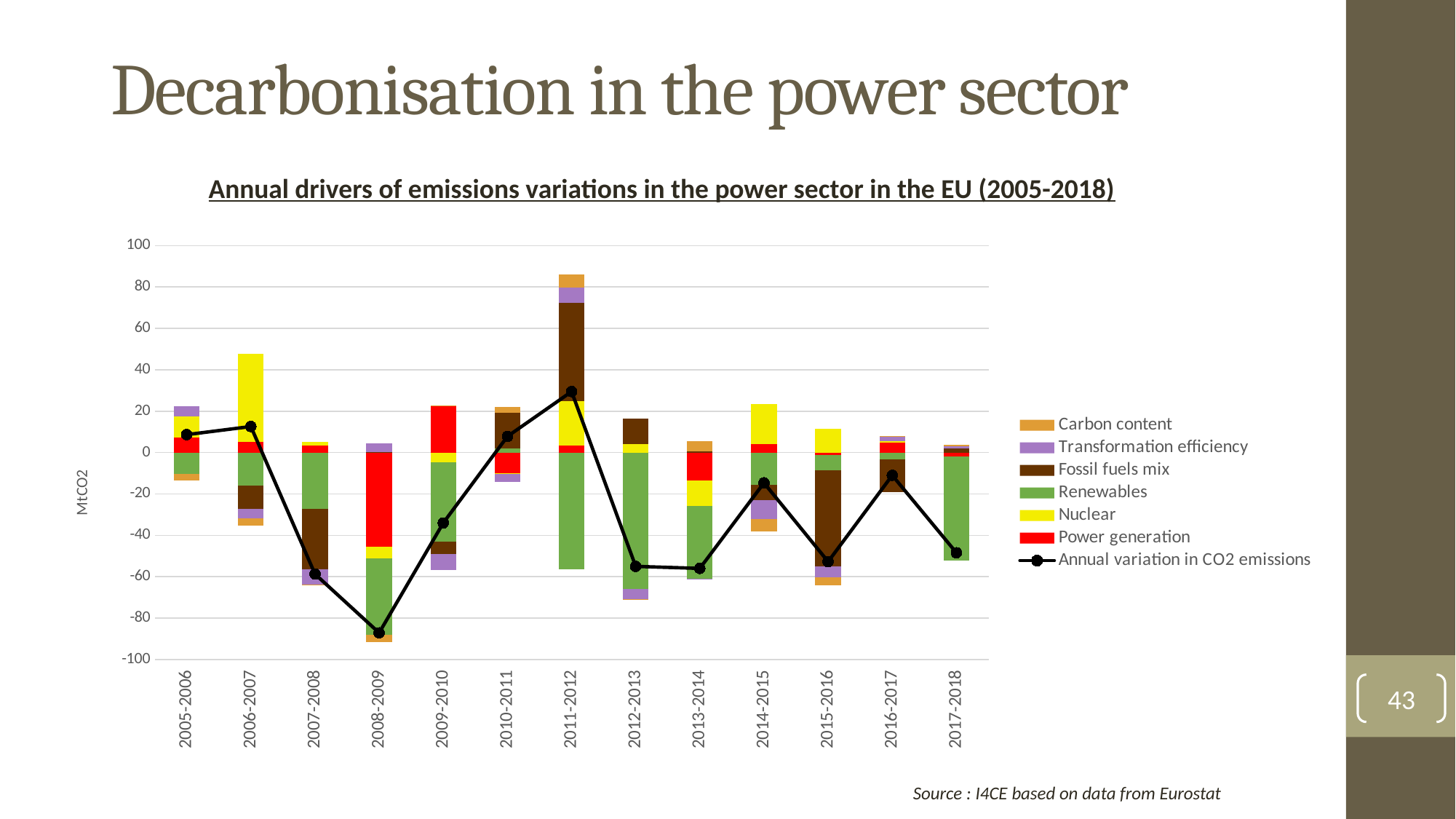
Is the annual variation in CO2 emissions for 2007-2008 greater or less than -40? less Does the annual variation in CO2 emissions line rise or fall from 2005-2006 to 2008-2009? fall How many series does the legend list? 7 Is the annual variation in CO2 emissions for 2008-2009 greater or less than -80? less In which period is the annual variation in CO2 emissions line at its lowest? 2008-2009 Which colour represents Renewables in the legend? green In which period is the annual variation in CO2 emissions line at its highest? 2011-2012 What unit is shown on the y axis? MtCO2 What kind of chart is shown on the slide? stacked bar chart with a line Which has the larger annual variation in CO2 emissions, 2006-2007 or 2011-2012? 2011-2012 How many year-pair categories are shown on the x axis? 13 Is the annual variation in CO2 emissions for 2011-2012 greater or less than 20? greater